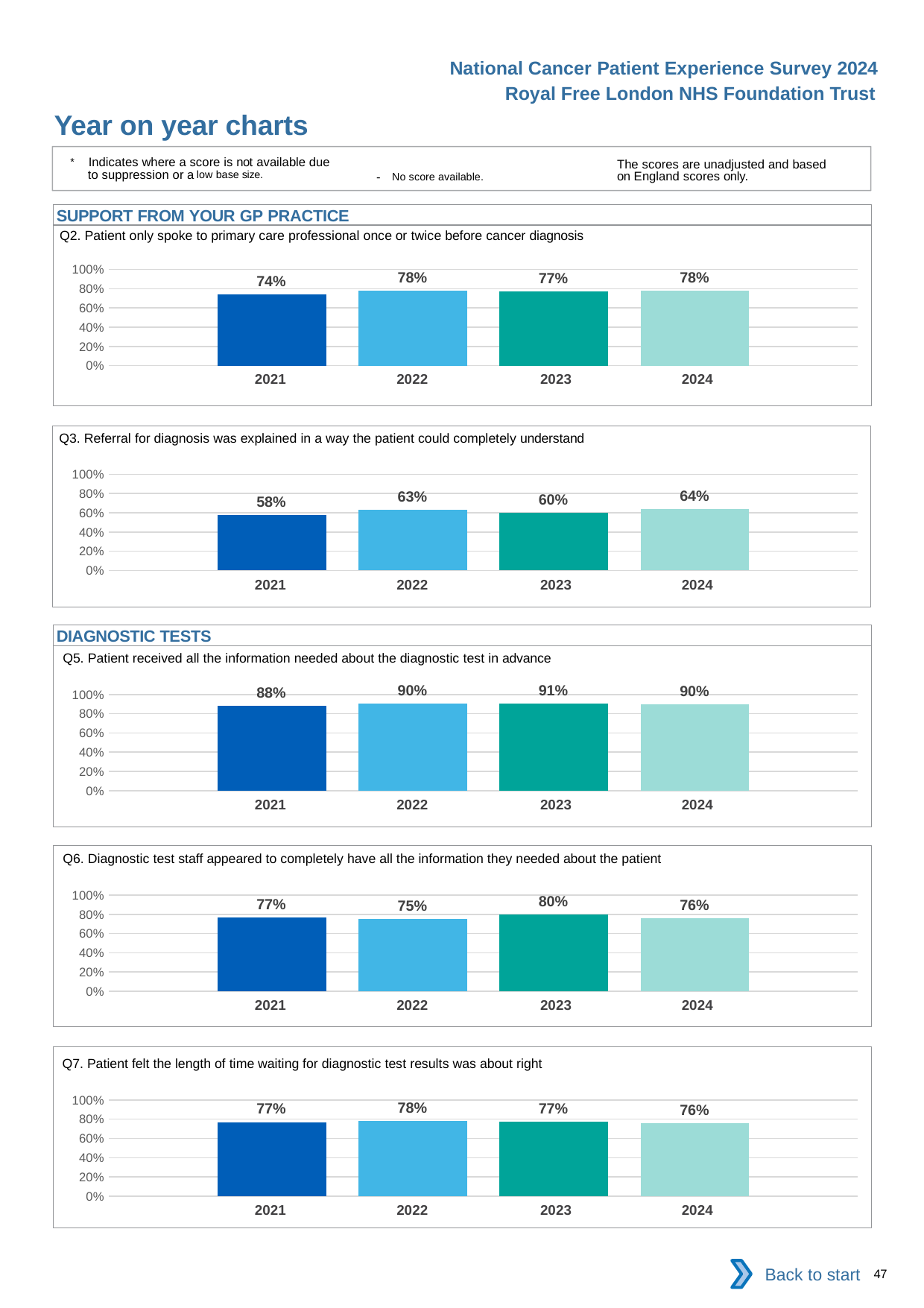
In the Q2 chart, what is the value for 2021? 74% In the Q6 chart, which is larger, the value for 2021 or the value for 2022? 2021 In the Q3 chart, which year has the highest value? 2024 In the Q5 chart, what is the value for 2023? 91% In the Q7 chart, what is the difference between the 2022 and 2024 values? 2% In the Q3 chart, what is the difference between the 2024 and 2021 values? 6% In the Q7 chart, what is the value for 2024? 76% In the Q3 chart, which year has the lowest value? 2021 In the Q6 chart, which year has the highest value? 2023 In the Q5 chart, is the value for 2021 greater or less than 80%? greater What kind of chart is the Q5 chart? Bar chart How many years are shown in the Q2 chart? 4